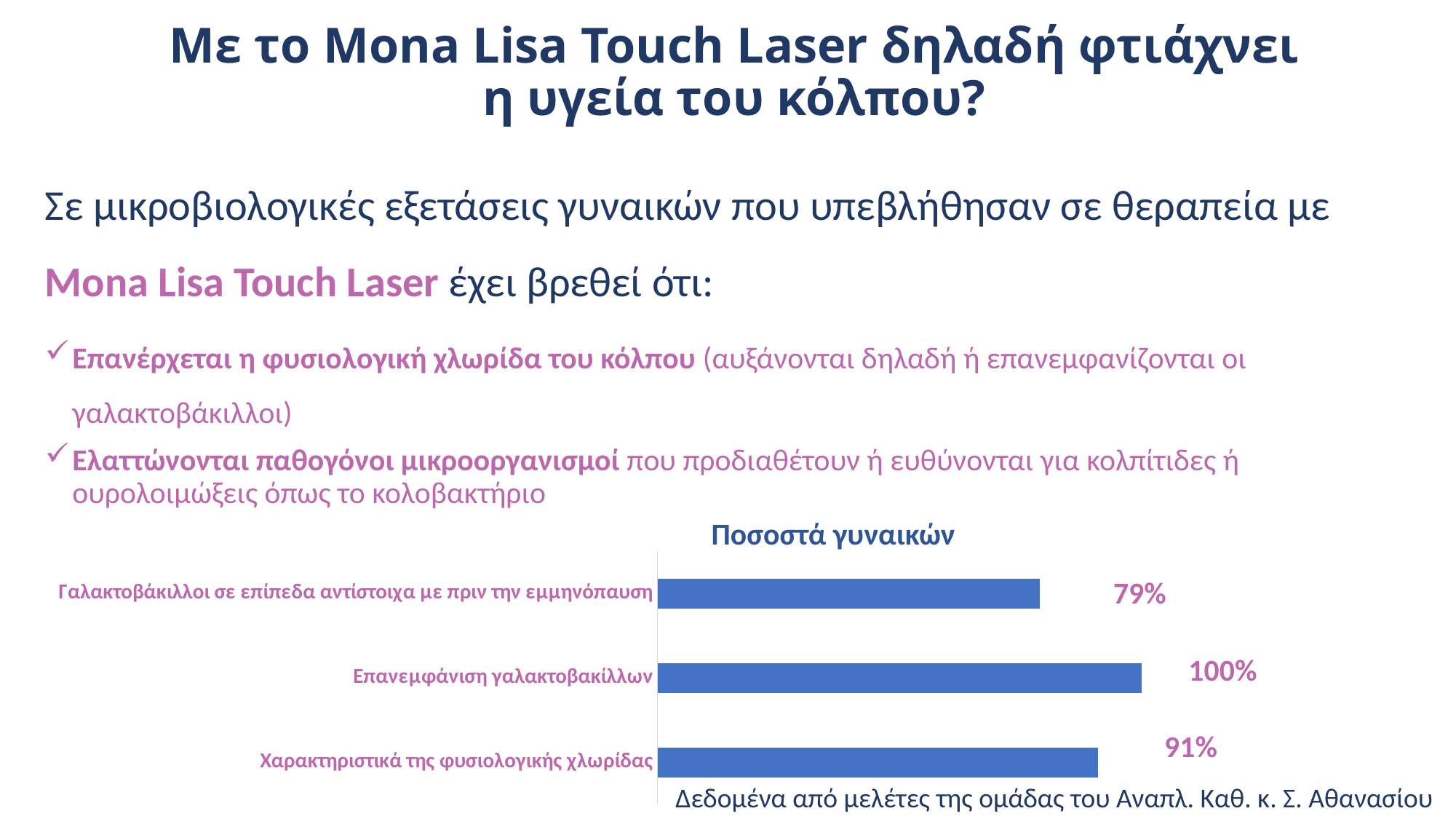
What colour are the bars in the chart? Blue Which category has the highest value? Επανεμφάνιση γαλακτοβακίλλων How many categories does the chart show? 3 What is the value for 'Επανεμφάνιση γαλακτοβακίλλων'? 100% Which category has the lowest value? Γαλακτοβάκιλλοι σε επίπεδα αντίστοιχα με πριν την εμμηνόπαυση What is the value for 'Γαλακτοβάκιλλοι σε επίπεδα αντίστοιχα με πριν την εμμηνόπαυση'? 79% What is the difference between the values for 'Χαρακτηριστικά της φυσιολογικής χλωρίδας' and 'Γαλακτοβάκιλλοι σε επίπεδα αντίστοιχα με πριν την εμμηνόπαυση'? 12% Which is larger: the value for 'Χαρακτηριστικά της φυσιολογικής χλωρίδας' or for 'Γαλακτοβάκιλλοι σε επίπεδα αντίστοιχα με πριν την εμμηνόπαυση'? Χαρακτηριστικά της φυσιολογικής χλωρίδας What is the difference between the values for 'Επανεμφάνιση γαλακτοβακίλλων' and 'Γαλακτοβάκιλλοι σε επίπεδα αντίστοιχα με πριν την εμμηνόπαυση'? 21% What is the title of the chart? Ποσοστά γυναικών What kind of chart is shown on the slide? Bar chart What is the value for 'Χαρακτηριστικά της φυσιολογικής χλωρίδας'? 91%